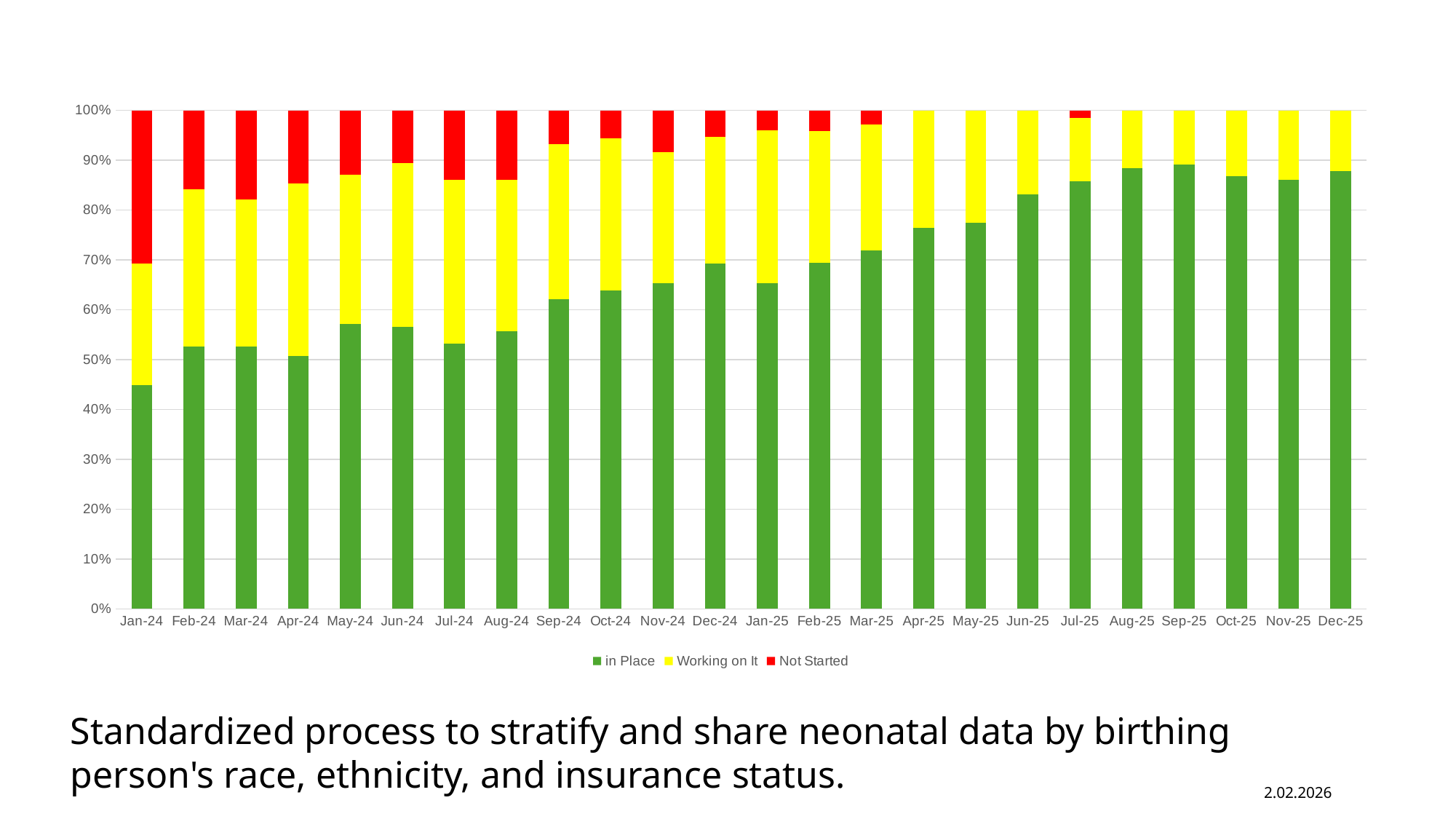
What is the total of the stacked bar for Jan-24? 100% How many series does the chart's legend list? 3 Is the 'in Place' value for Dec-25 greater or less than 80%? greater Which series is shown in red in the legend? Not Started Is the 'Not Started' share for Jan-24 greater or less than 20%? greater Is the 'in Place' value for Jan-24 greater or less than 50%? less Which month has the largest 'Not Started' share? Jan-24 Does the 'in Place' share generally rise or fall from Jan-24 to Dec-25? Rise Which month has the lowest 'in Place' share? Jan-24 What kind of chart is shown on the slide? Stacked bar chart How many months are shown along the x axis of the chart? 24